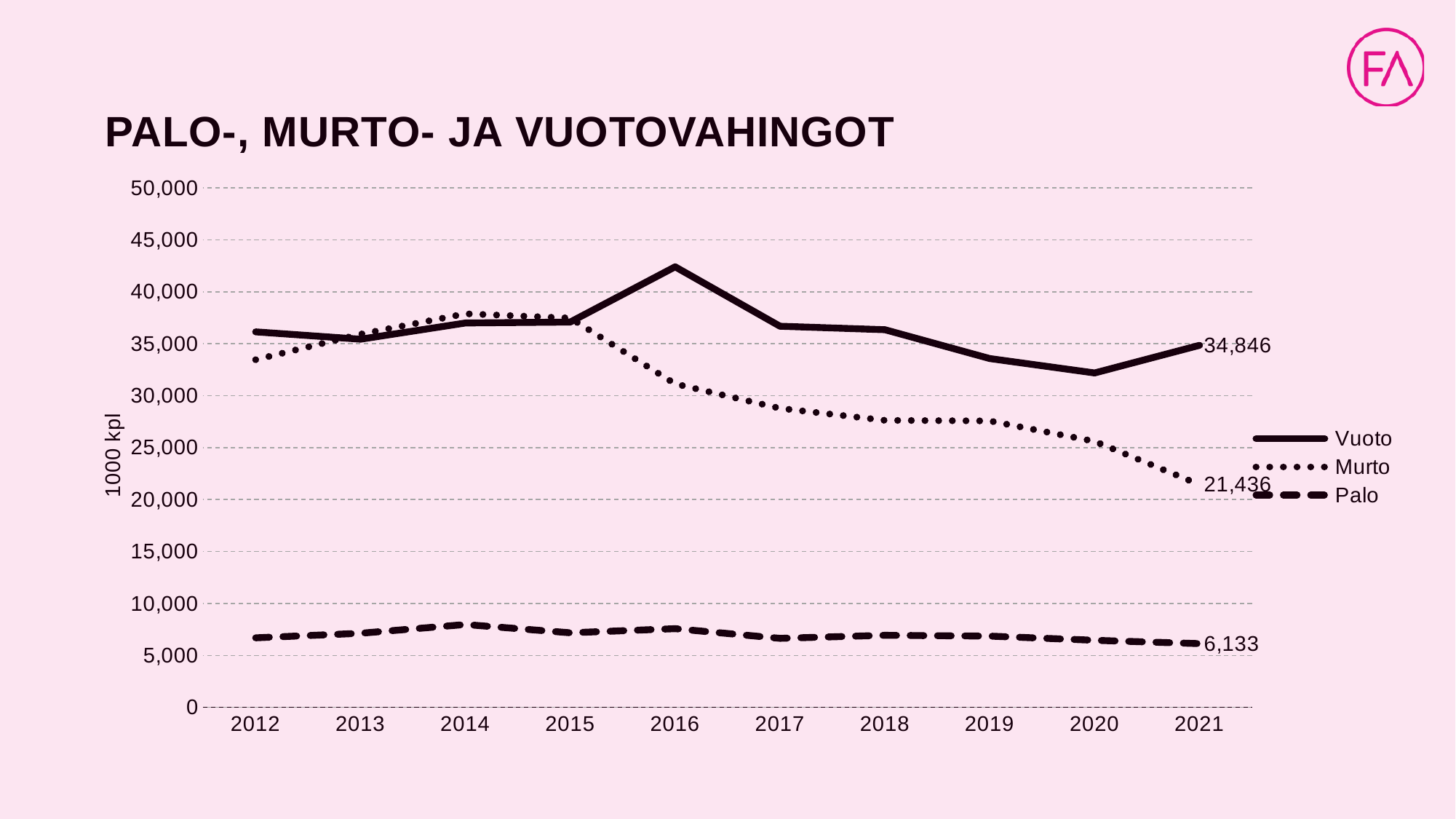
What is the value of the Palo series in 2021? 6,133 Is the value for Murto in 2018 greater or less than 30,000? less Does the Murto series rise or fall from 2015 to 2021? fall In 2021, which series has the larger value, Vuoto or Murto? Vuoto Is the value for Vuoto in 2016 greater or less than 40,000? greater How many series does the legend list? 3 What is the value of the Vuoto series in 2021? 34,846 In which year does the Vuoto series reach its highest value? 2016 In which year does the Murto series reach its lowest value? 2021 What is the value of the Murto series in 2021? 21,436 What is the difference between the Murto and Palo values in 2021? 15,303 What is the difference between the Vuoto and Murto values in 2021? 13,410